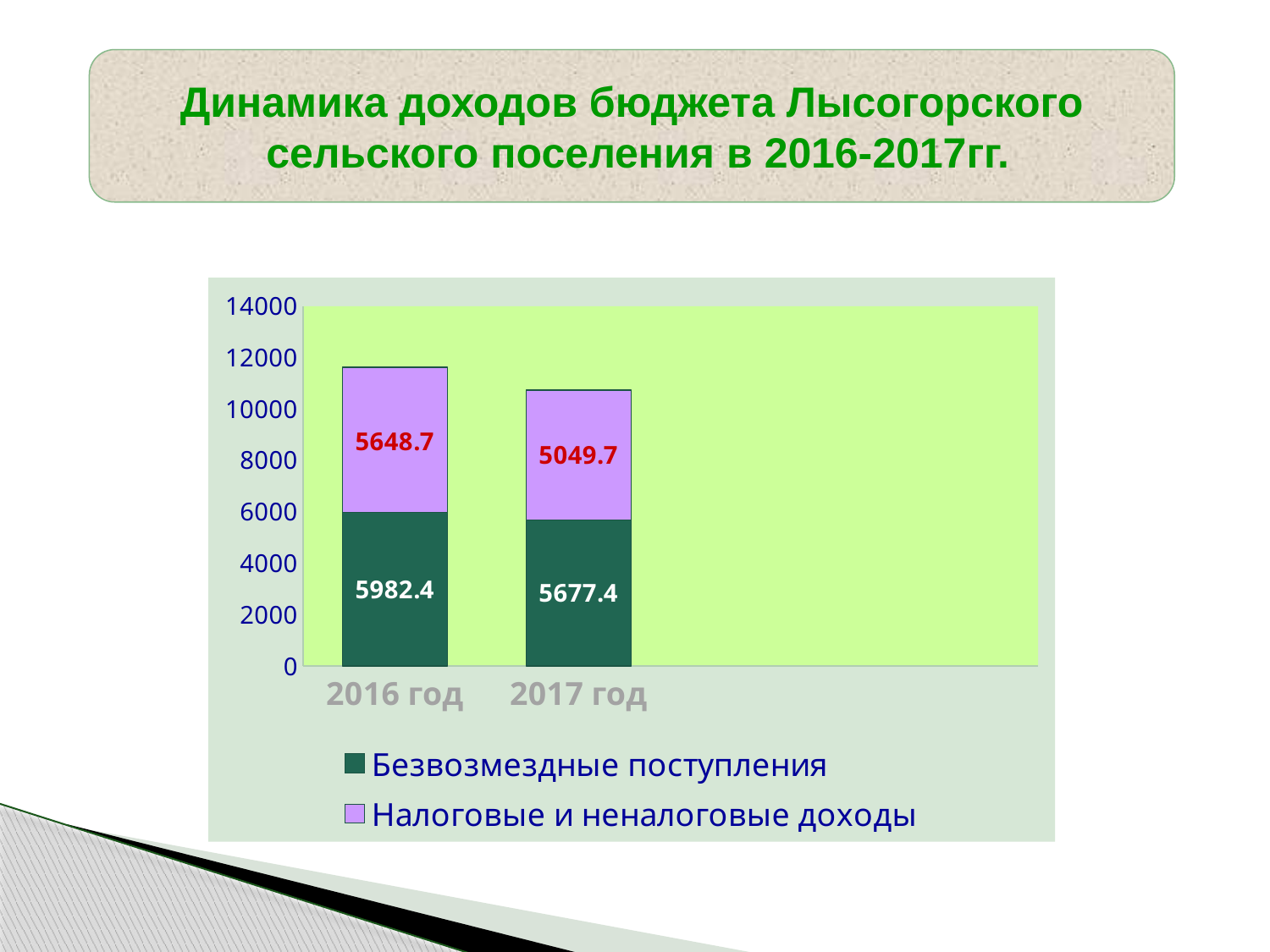
What is the total of the stacked bar for 2016 год? 11631.1 Which year has the higher value for Налоговые и неналоговые доходы, 2016 год or 2017 год? 2016 год What is the total of the stacked bar for 2017 год? 10727.1 What is the value of Налоговые и неналоговые доходы for 2017 год? 5049.7 Do the total bar heights rise or fall from 2016 год to 2017 год? Fall What kind of chart is shown on the slide? Stacked bar chart What is the difference in Безвозмездные поступления between 2016 год and 2017 год? 305 What is the value of Безвозмездные поступления for 2017 год? 5677.4 What is the value of Безвозмездные поступления for 2016 год? 5982.4 How many series does the legend list? 2 What is the value of Налоговые и неналоговые доходы for 2016 год? 5648.7 By how much did Налоговые и неналоговые доходы decrease from 2016 год to 2017 год? 599